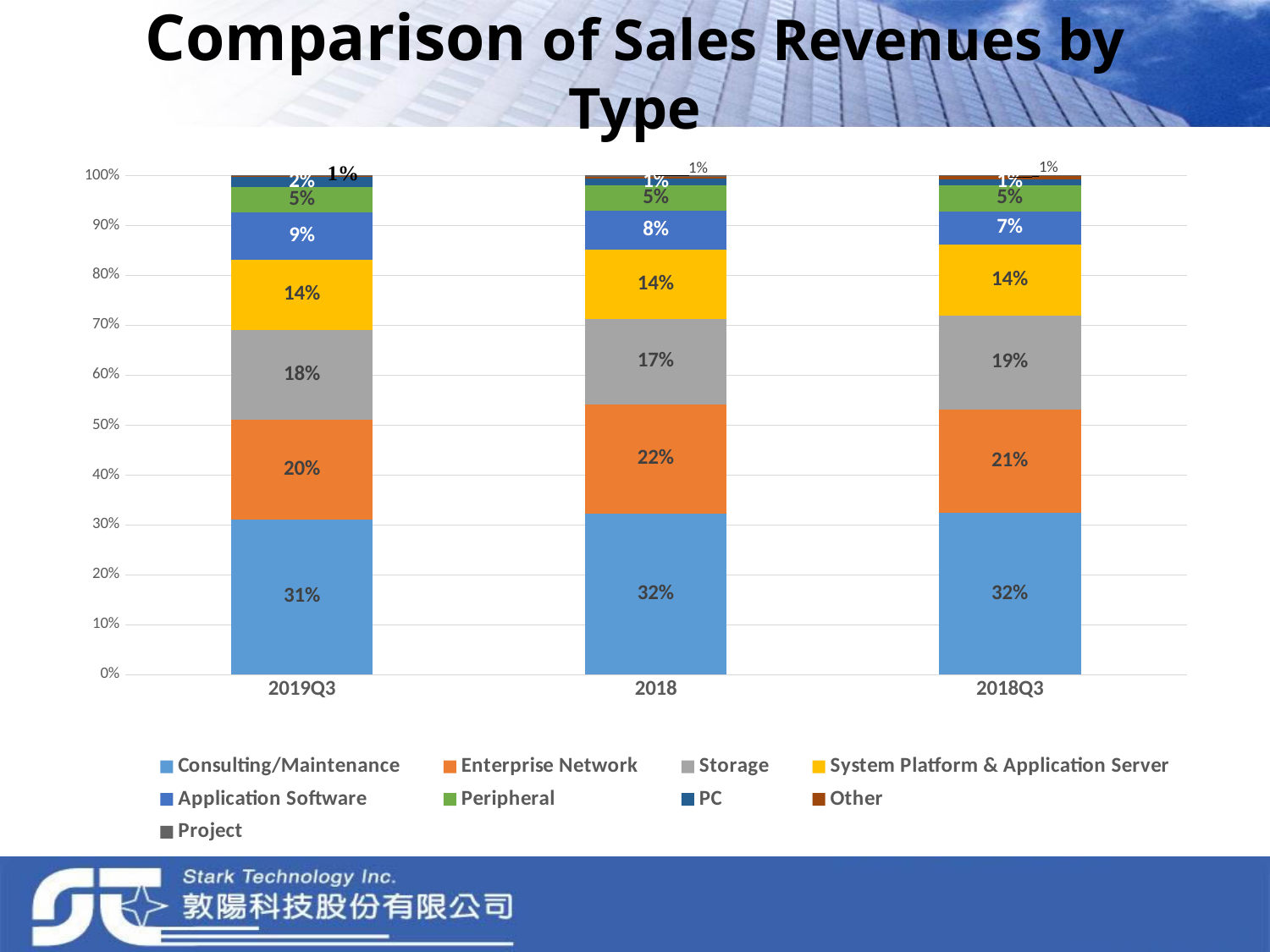
What is the System Platform & Application Server share for 2018? 14% By how many percentage points does the Storage share in 2018Q3 exceed the Storage share in 2018? 2% What share of sales revenue did Consulting/Maintenance account for in 2019Q3? 31% What is the Enterprise Network share for 2018? 22% What is the Storage share for 2018Q3? 19% Which period has the larger Enterprise Network share, 2018 or 2019Q3? 2018 What kind of chart is shown on the slide? Stacked bar chart How many periods are shown along the x axis of the chart? 3 What is the Application Software share for 2019Q3? 9% How many series does the legend list? 9 In which period is the Application Software share the highest? 2019Q3 What is the title of the chart on the slide? Comparison of Sales Revenues by Type